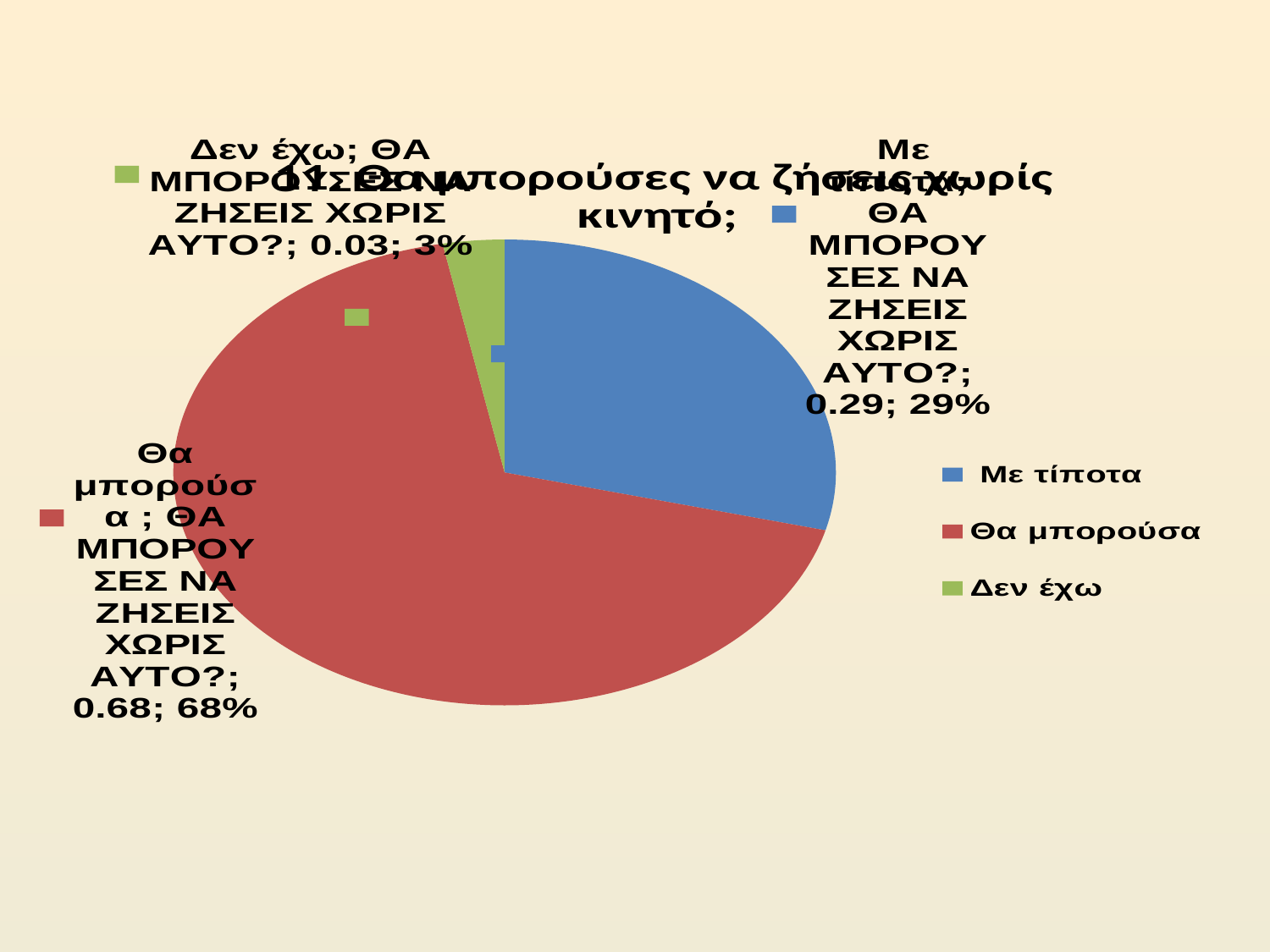
What share of the pie does the "Θα μπορούσα" slice represent? 68% What share of the pie does the "Δεν έχω" slice represent? 3% Which slice of the pie is the largest? Θα μπορούσα What is the difference in percentage points between the "Θα μπορούσα" and "Με τίποτα" slices? 39 Which slice of the pie is the smallest? Δεν έχω How many slices does the pie chart have? 3 What kind of chart is shown on the slide? pie chart What share of the pie does the "Με τίποτα" slice represent? 29% What colour is the "Θα μπορούσα" slice? red What value is printed for the "Θα μπορούσα" slice before its percentage? 0.68 Which slice is larger, "Με τίποτα" or "Δεν έχω"? Με τίποτα What value is printed for the "Με τίποτα" slice before its percentage? 0.29